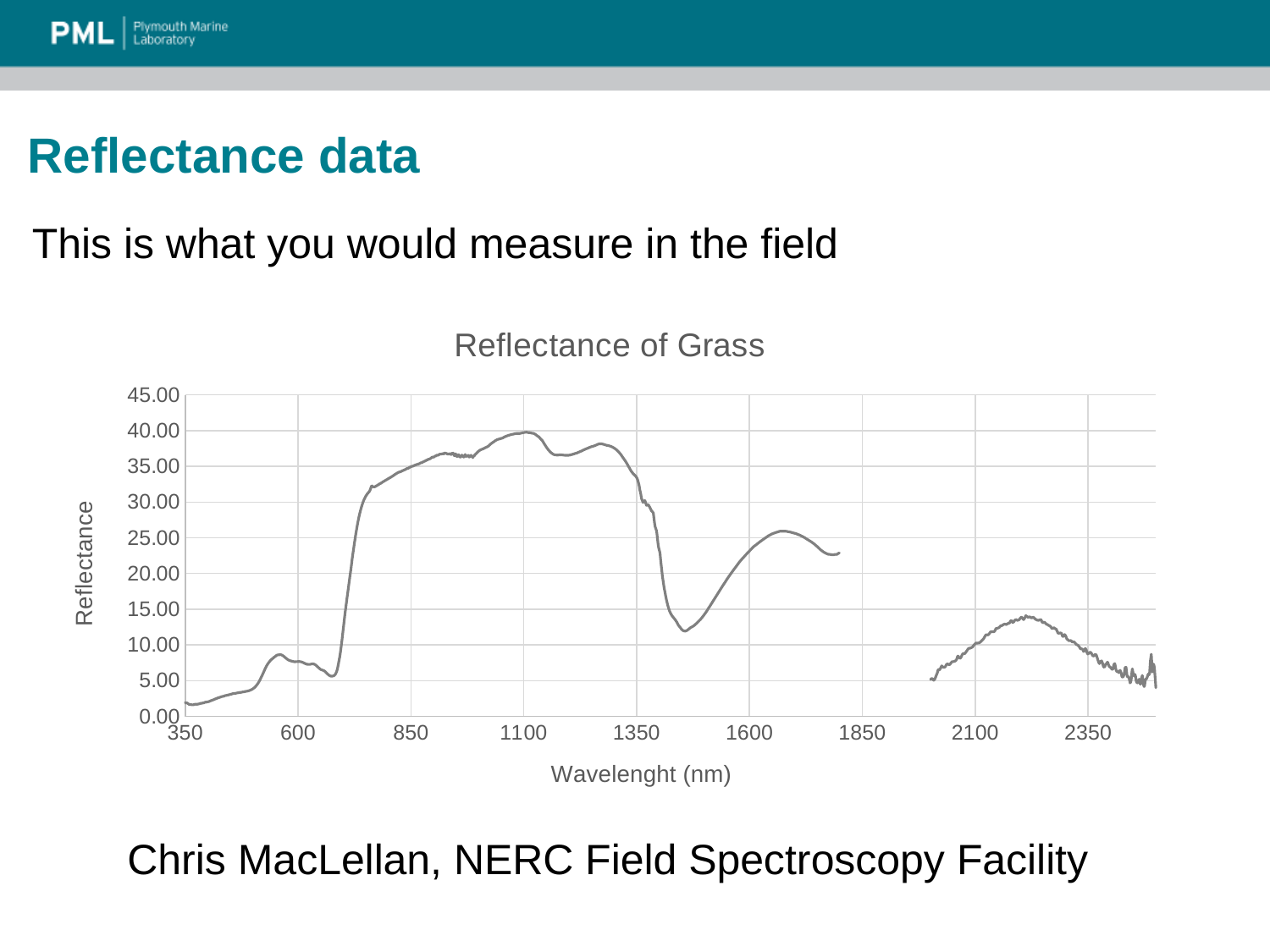
Near which x-axis tick does the reflectance curve reach its highest value? 1100 Is the reflectance value at 600 nm greater or less than 10.00? less Does the reflectance rise or fall as the wavelength increases from 1350 nm to 1450 nm? fall Is the reflectance value at 2200 nm greater or less than 20.00? less Is the reflectance value at 850 nm greater or less than 30.00? greater What kind of chart is shown on the slide? line chart What is the title of the chart? Reflectance of Grass Does the reflectance rise or fall as the wavelength increases from 600 nm to 850 nm? rise What is the label of the x axis of the chart? Wavelenght (nm)